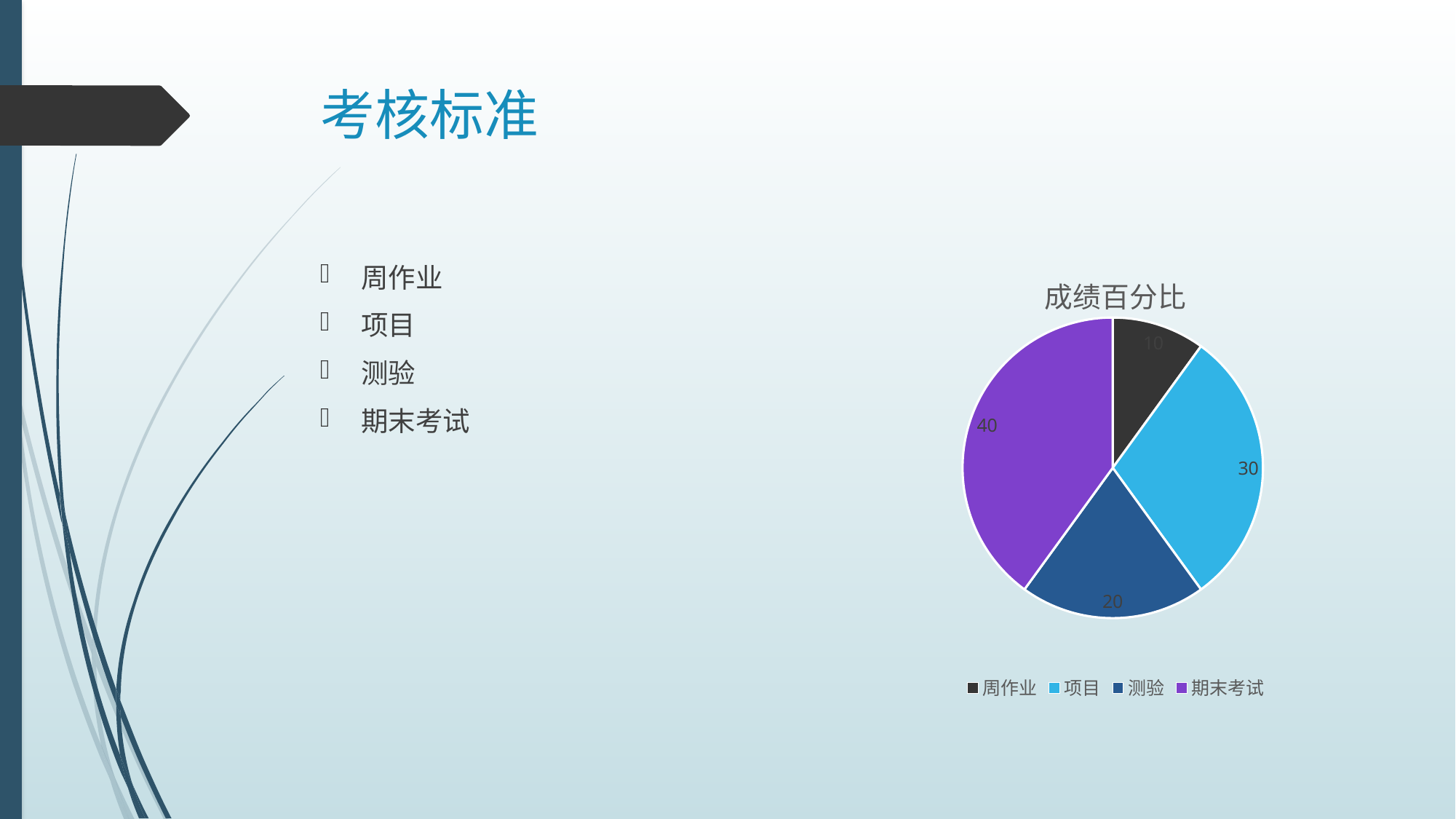
What is the value for 项目 in the pie chart? 30 What is the value for 周作业 in the pie chart? 10 What is the difference between the values for 期末考试 and 测验? 20 Which category has the largest slice in the pie chart? 期末考试 What share of the pie does 期末考试 represent? 40% What is the title of the chart? 成绩百分比 How many slices does the pie chart have? 4 What is the value for 期末考试 in the pie chart? 40 What kind of chart is shown on the slide? Pie chart What is the value for 测验 in the pie chart? 20 Which is larger, the value for 项目 or the value for 测验? 项目 Which category has the smallest slice in the pie chart? 周作业